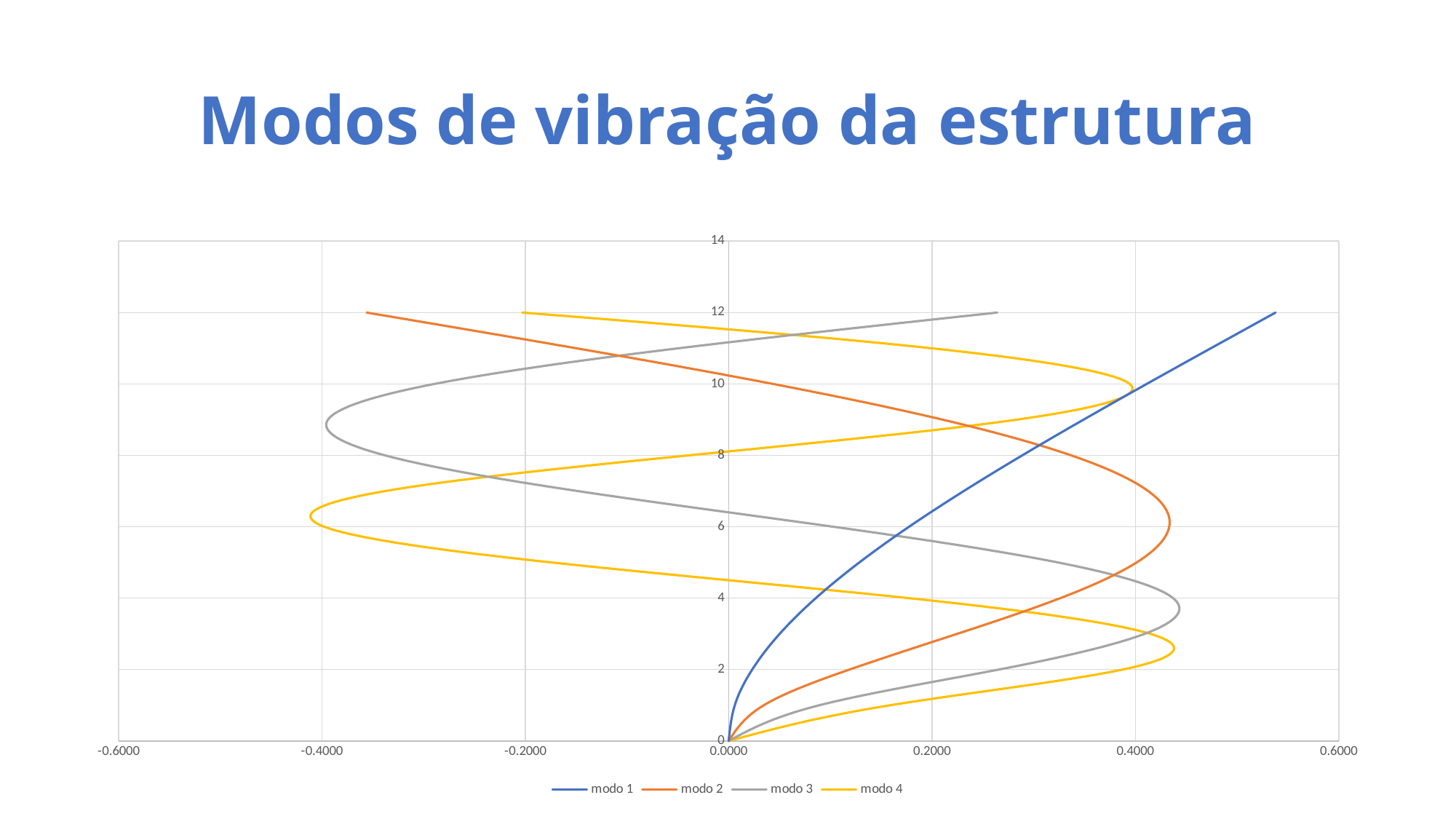
At height 12, is the value for modo 4 greater or less than 0.0000? less What kind of chart is shown on the slide? line chart At height 12, is the value for modo 3 greater or less than 0.2000? greater What is the title of the slide containing the chart? Modos de vibração da estrutura At height 12, is the value for modo 1 greater or less than 0.4000? greater What are the series names listed in the legend? modo 1, modo 2, modo 3, modo 4 Which series reaches the highest x value at height 12? modo 1 As height increases from 0 to 12, does the x value of modo 1 rise or fall? rise Which series has the lowest x value at height 12? modo 2 How many series does the legend list? 4 At height 12, which series has the larger x value, modo 1 or modo 3? modo 1